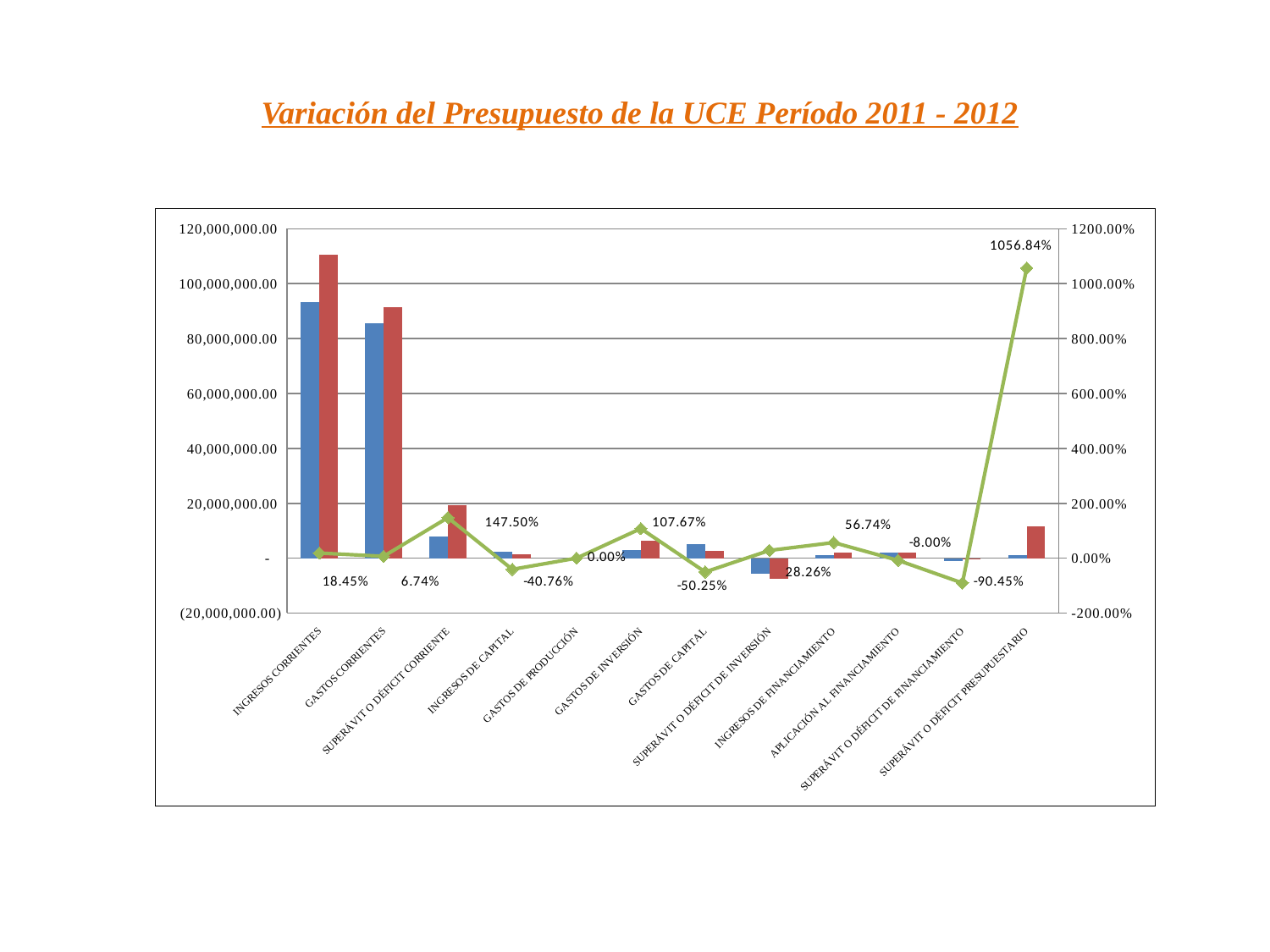
What is the difference between the percentage values for SUPERÁVIT O DÉFICIT CORRIENTE (147.50%) and GASTOS DE INVERSIÓN (107.67%)? 39.83 percentage points What percentage value is labelled on the line for SUPERÁVIT O DÉFICIT DE FINANCIAMIENTO? -90.45% Which category has the lowest percentage value on the line? SUPERÁVIT O DÉFICIT DE FINANCIAMIENTO What percentage value is labelled on the line for INGRESOS CORRIENTES? 18.45% What percentage value is labelled on the line for SUPERÁVIT O DÉFICIT PRESUPUESTARIO? 1056.84% How many categories are shown on the x axis? 12 Which category has the highest percentage value on the line? SUPERÁVIT O DÉFICIT PRESUPUESTARIO What percentage value is labelled on the line for GASTOS DE PRODUCCIÓN? 0.00% What kind of chart is shown on the slide? A combination bar and line chart Is the blue bar for INGRESOS CORRIENTES greater or less than 80,000,000.00? greater Which has the larger percentage value on the line: GASTOS DE INVERSIÓN or INGRESOS DE FINANCIAMIENTO? GASTOS DE INVERSIÓN What percentage value is labelled on the line for GASTOS DE CAPITAL? -50.25%